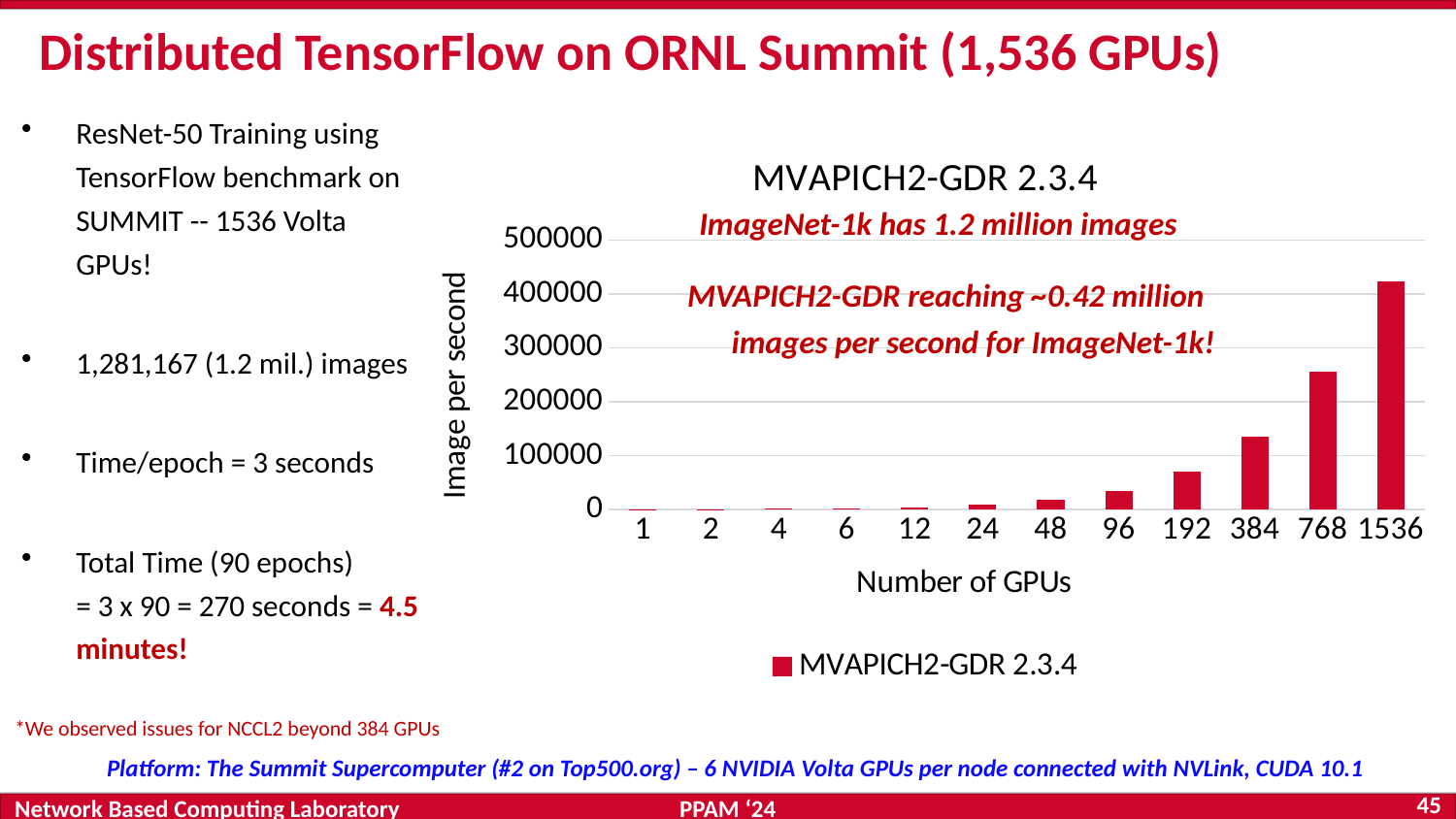
Which number of GPUs has the highest images per second? 1536 Is the value for 768 GPUs greater or less than 300000? less Is the value for 1536 GPUs greater or less than 400000? greater Is the value for 768 GPUs greater or less than 200000? greater What is the title of the chart? MVAPICH2-GDR 2.3.4 How many series does the chart's legend list? 1 Do the values rise or fall as the number of GPUs increases along the x axis? rise How many GPU-count categories are plotted on the x axis? 12 What kind of chart is shown on the slide? bar chart What is the label of the x axis of the chart? Number of GPUs Which has the larger images per second, 192 GPUs or 384 GPUs? 384